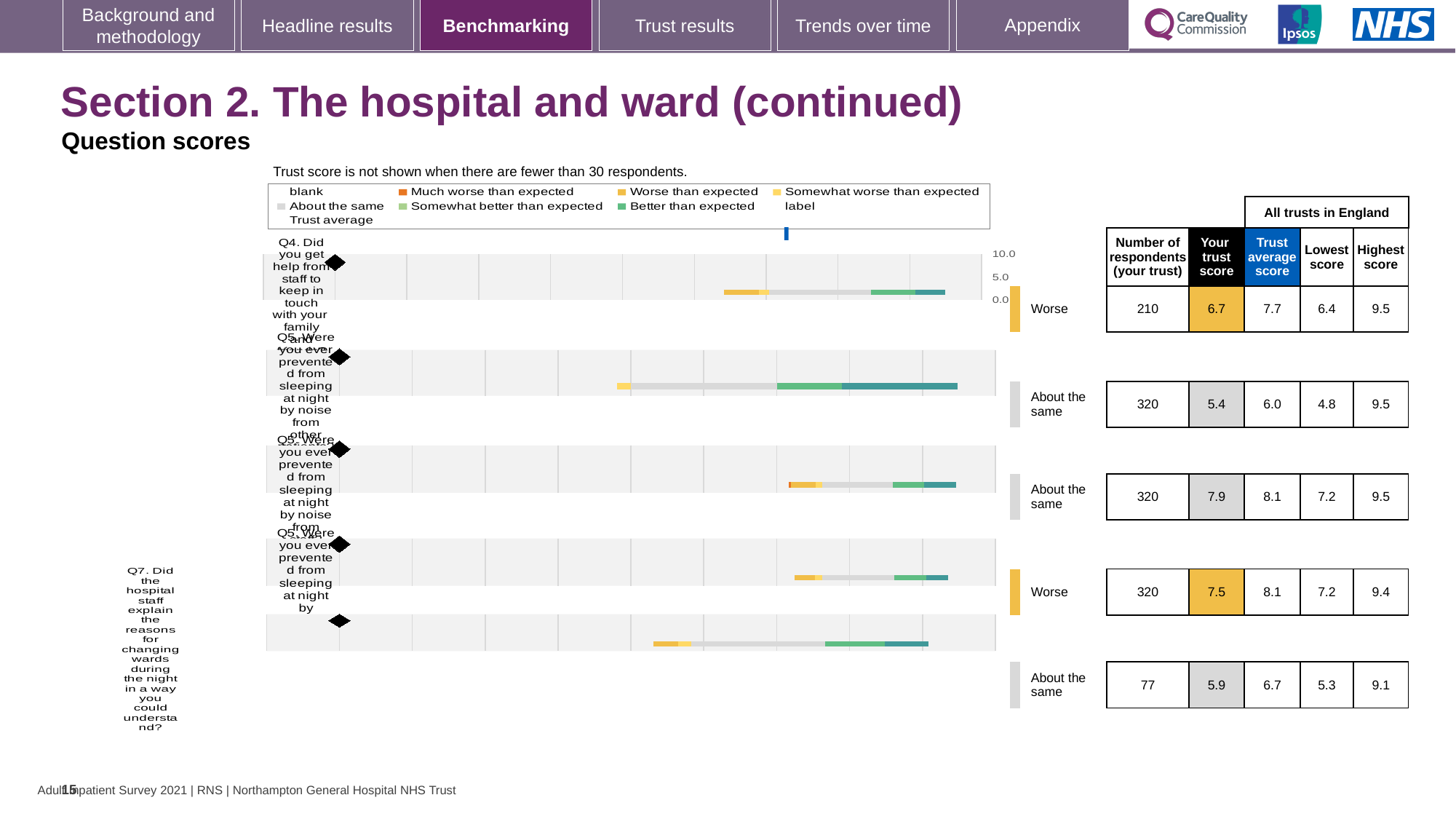
What is the 'Your trust score' for Q7 (explaining reasons for changing wards during the night), the last row? 5.9 For Q4 (first row), what is the difference between the trust average score (7.7) and your trust score (6.7)? 1.0 What is the maximum value shown on the chart's score axis? 10.0 How many question rows (bars) are plotted in the chart? 5 What kind of chart is used to show the question scores on this slide? bar chart What is the highest score across all trusts in England for Q7, the last row? 9.1 For Q4 (first row), which is larger: your trust score or the trust average score? trust average score Which row has the highest 'Your trust score' value? the third row (7.9) What is the 'Your trust score' for Q4 (help from staff to keep in touch with family), the first row? 6.7 How many of the five rows are rated 'Worse' rather than 'About the same'? 2 Which row has the lowest 'Your trust score' value? the second row (5.4) How many respondents answered Q4, the first row of the chart? 210